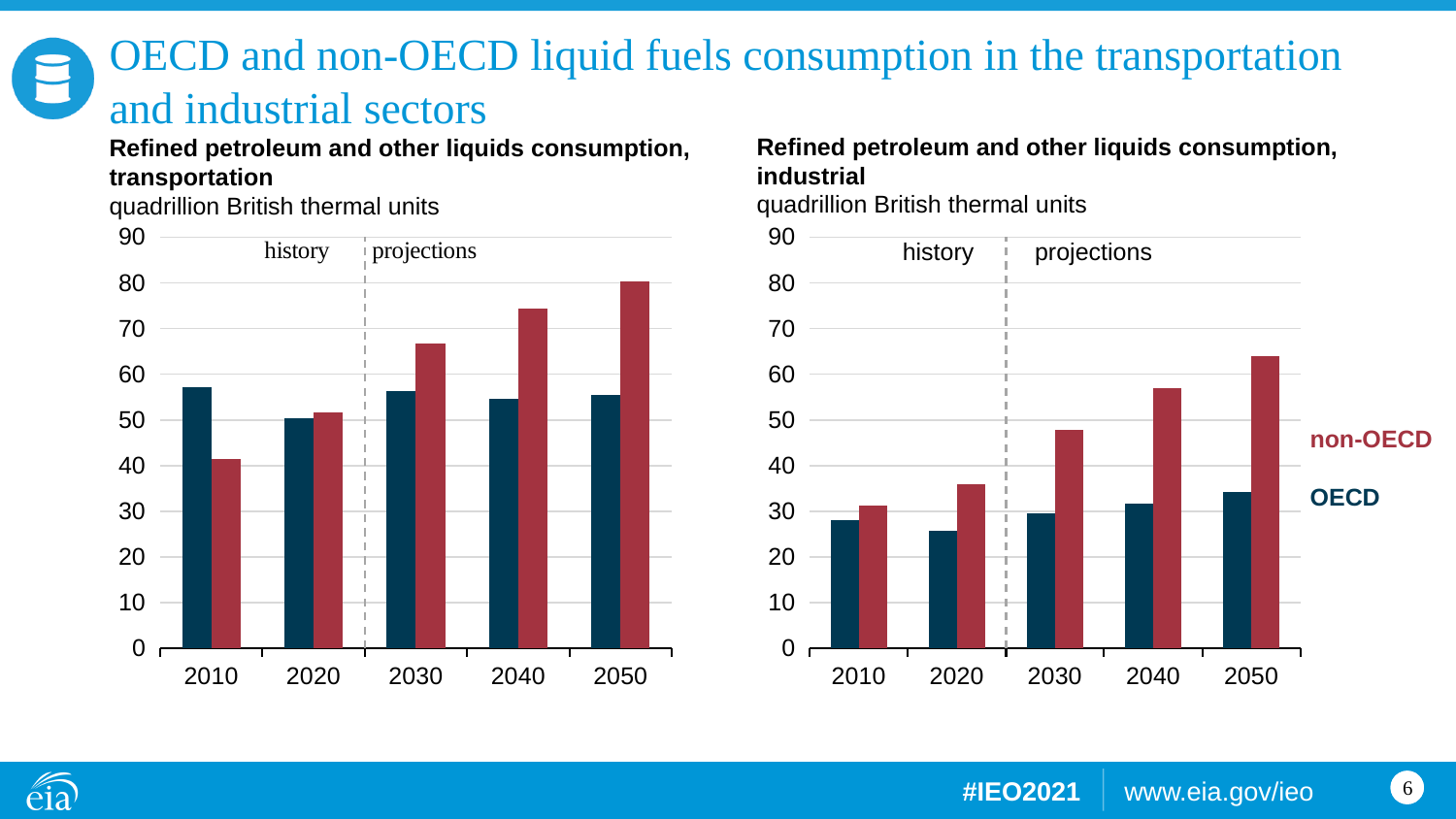
In the 'Refined petroleum and other liquids consumption, transportation' chart, in which year is the non-OECD value highest? 2050 In the 'Refined petroleum and other liquids consumption, industrial' chart, do the non-OECD values rise or fall from 2010 to 2050? rise In the 'Refined petroleum and other liquids consumption, industrial' chart, is the OECD value for 2020 greater or less than 30? less What unit of measurement is used on both charts? quadrillion British thermal units What kind of chart is the 'Refined petroleum and other liquids consumption, transportation' chart? bar chart In the 'Refined petroleum and other liquids consumption, industrial' chart, how many years are shown on the x axis? 5 In the 'Refined petroleum and other liquids consumption, transportation' chart, is the non-OECD value for 2050 greater or less than 70? greater In the 'Refined petroleum and other liquids consumption, transportation' chart, is the OECD value for 2020 greater or less than 60? less In the 'Refined petroleum and other liquids consumption, industrial' chart, how many series does the legend list? 2 In the 'Refined petroleum and other liquids consumption, transportation' chart, in which year is the non-OECD value lowest? 2010 In the 'Refined petroleum and other liquids consumption, transportation' chart, which is larger in 2010, OECD or non-OECD? OECD In the 'Refined petroleum and other liquids consumption, industrial' chart, which is larger in 2050, OECD or non-OECD? non-OECD